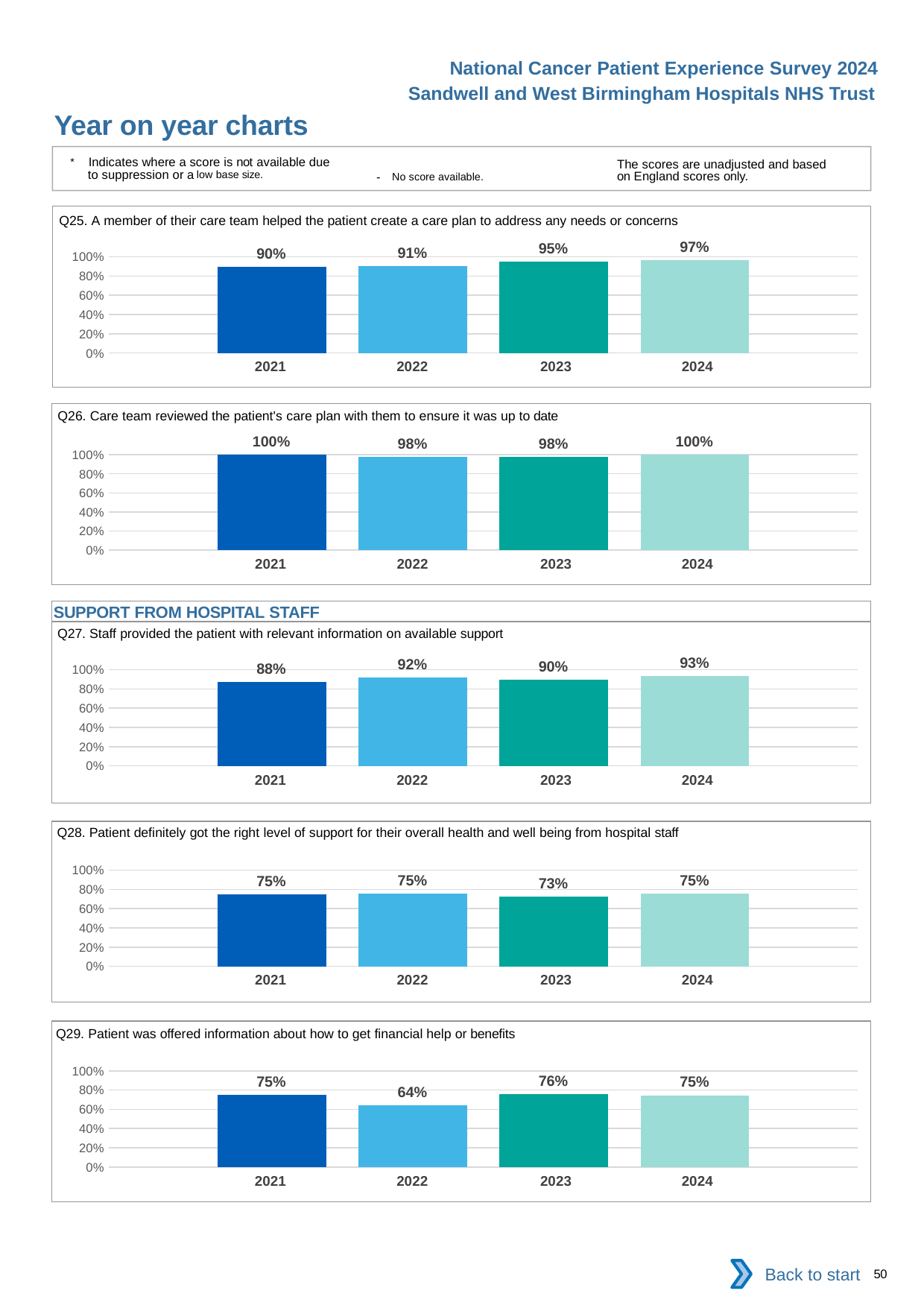
In the Q25 chart, do the values rise or fall from 2021 to 2024? rise In the Q28 chart, what is the value for 2023? 73% In the Q29 chart, which year has the lowest value? 2022 In the Q26 chart, what is the value for 2022? 98% In the Q27 chart, which year has the lowest value? 2021 In the Q25 chart, what is the value for 2024? 97% In the Q29 chart, which is larger, the value for 2021 or the value for 2022? 2021 How many years are shown on the x axis of the Q25 chart? 4 In the Q29 chart, what is the difference between the 2023 and 2022 values? 12% In the Q26 chart, what is the difference between the 2021 and 2023 values? 2% In the Q27 chart, which year has the highest value? 2024 In the Q28 chart, is the value for 2021 greater or less than 60%? greater